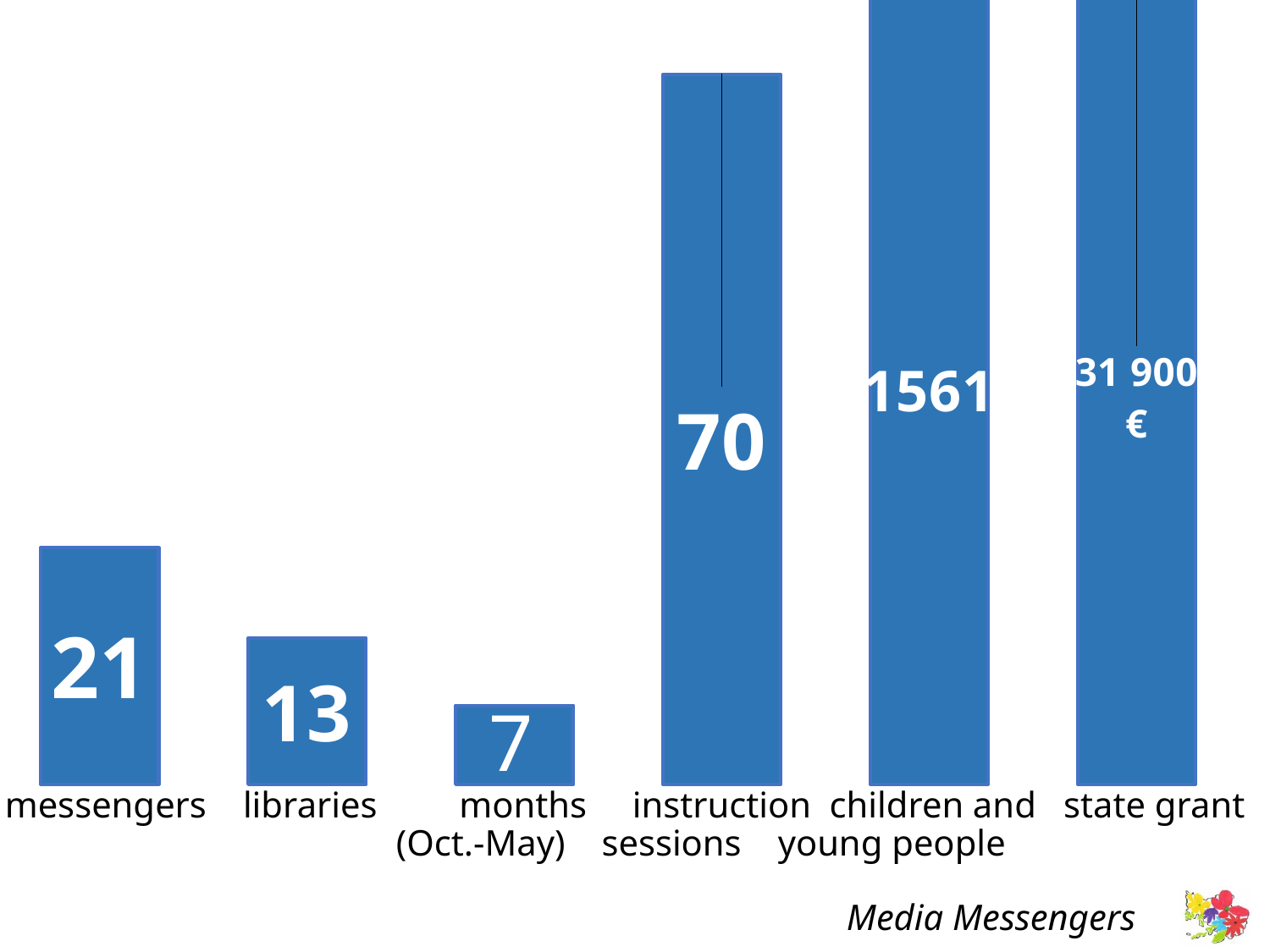
Which is larger, the value for instruction sessions or the value for messengers? instruction sessions What is the difference between the values for messengers and libraries? 8 What kind of chart is shown on the slide? bar chart What is the value for messengers? 21 What is the value for months (Oct.-May)? 7 Which category has the highest value? state grant What is the value for children and young people? 1561 What is the value for state grant? 31 900 € How many categories are shown in the chart? 6 What is the value for instruction sessions? 70 Which category has the lowest value? months (Oct.-May) What is the value for libraries? 13